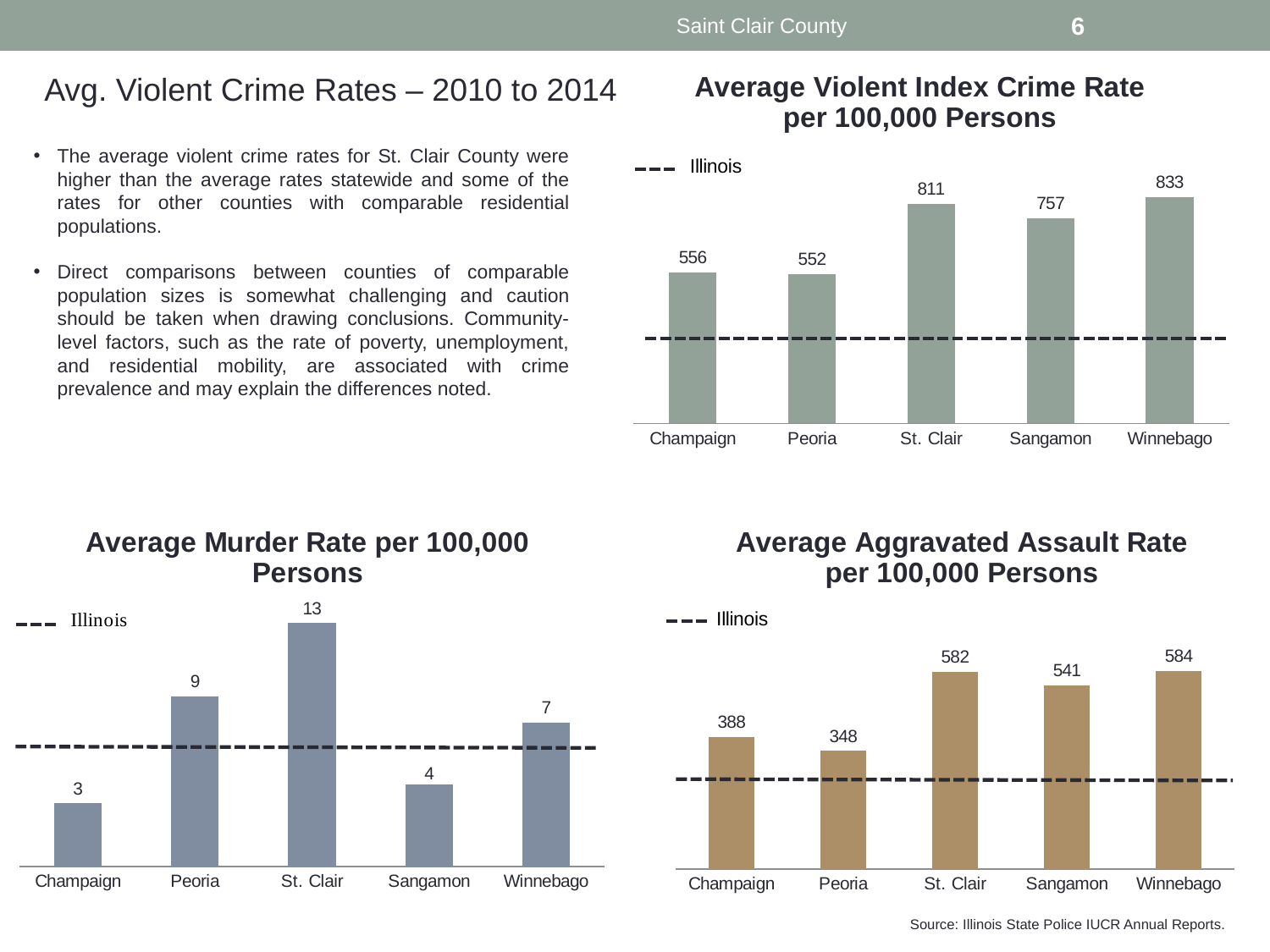
In the 'Average Violent Index Crime Rate per 100,000 Persons' chart, what is the value for St. Clair? 811 In the 'Average Murder Rate per 100,000 Persons' chart, which county has the lowest value? Champaign How many counties are shown in the 'Average Murder Rate per 100,000 Persons' chart? 5 In the 'Average Murder Rate per 100,000 Persons' chart, which is larger, Peoria or Winnebago? Peoria In the 'Average Murder Rate per 100,000 Persons' chart, what is the value for St. Clair? 13 In the 'Average Violent Index Crime Rate per 100,000 Persons' chart, what is the difference between Winnebago and Champaign? 277 In the 'Average Aggravated Assault Rate per 100,000 Persons' chart, what is the difference between St. Clair and Peoria? 234 In the 'Average Violent Index Crime Rate per 100,000 Persons' chart, which county has the highest value? Winnebago In the 'Average Aggravated Assault Rate per 100,000 Persons' chart, which county has the lowest value? Peoria In the 'Average Violent Index Crime Rate per 100,000 Persons' chart, which county has the lowest value? Peoria In the 'Average Aggravated Assault Rate per 100,000 Persons' chart, what is the value for Sangamon? 541 What type of chart is the 'Average Aggravated Assault Rate per 100,000 Persons' chart? Bar chart